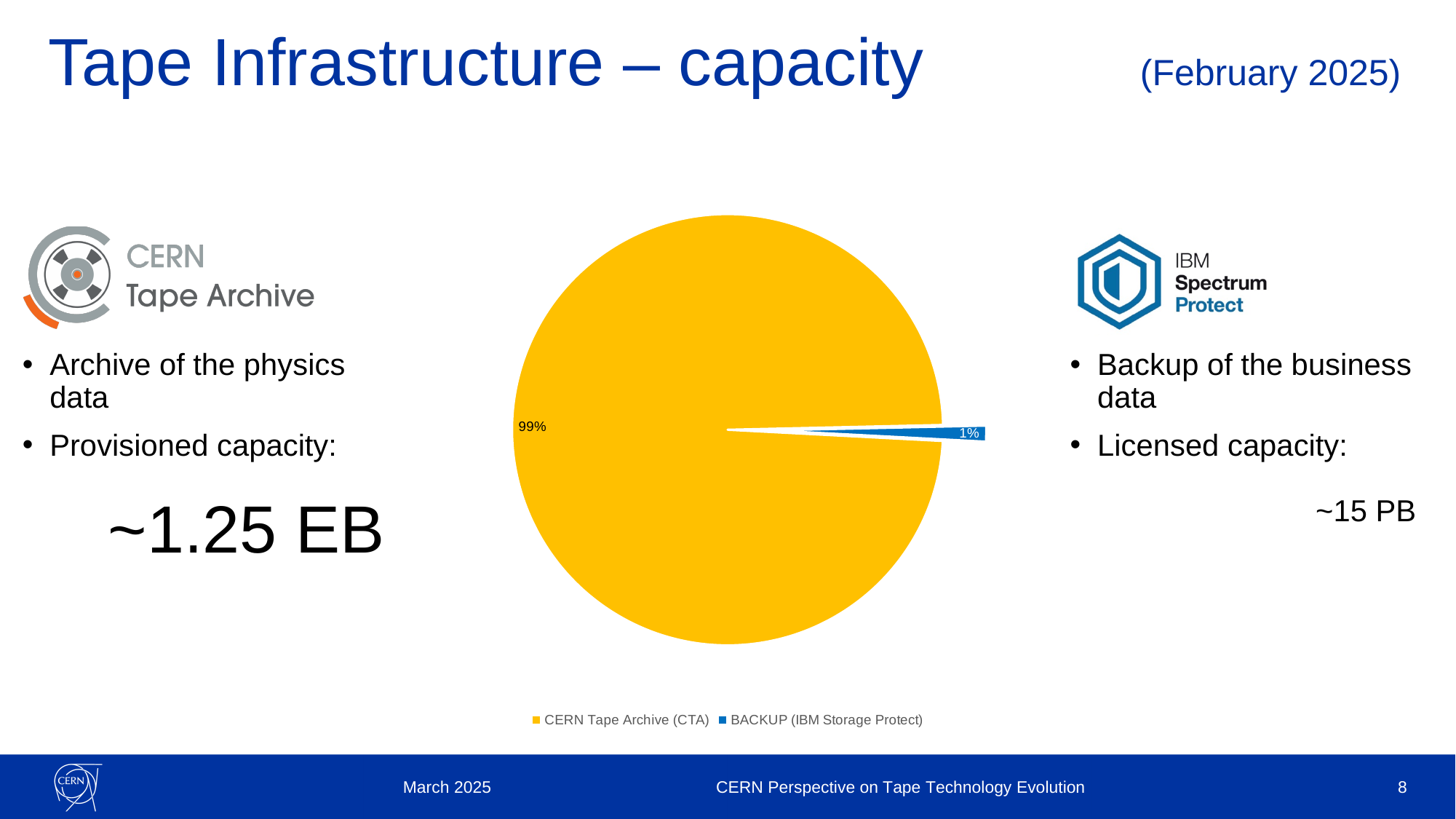
What colour is the CERN Tape Archive (CTA) slice in the pie chart? yellow How many entries does the legend list? 2 What share of the pie does BACKUP (IBM Storage Protect) have? 1% Which slice of the pie is the smallest? BACKUP (IBM Storage Protect) Which slice of the pie is the largest? CERN Tape Archive (CTA) What share of the pie does CERN Tape Archive (CTA) have? 99% What kind of chart is shown on the slide? pie chart What is the difference in percentage points between the CERN Tape Archive (CTA) share and the BACKUP (IBM Storage Protect) share? 98 percentage points What colour is the BACKUP (IBM Storage Protect) slice in the pie chart? blue How many slices does the pie chart have? 2 Which is larger, the share for CERN Tape Archive (CTA) or the share for BACKUP (IBM Storage Protect)? CERN Tape Archive (CTA)